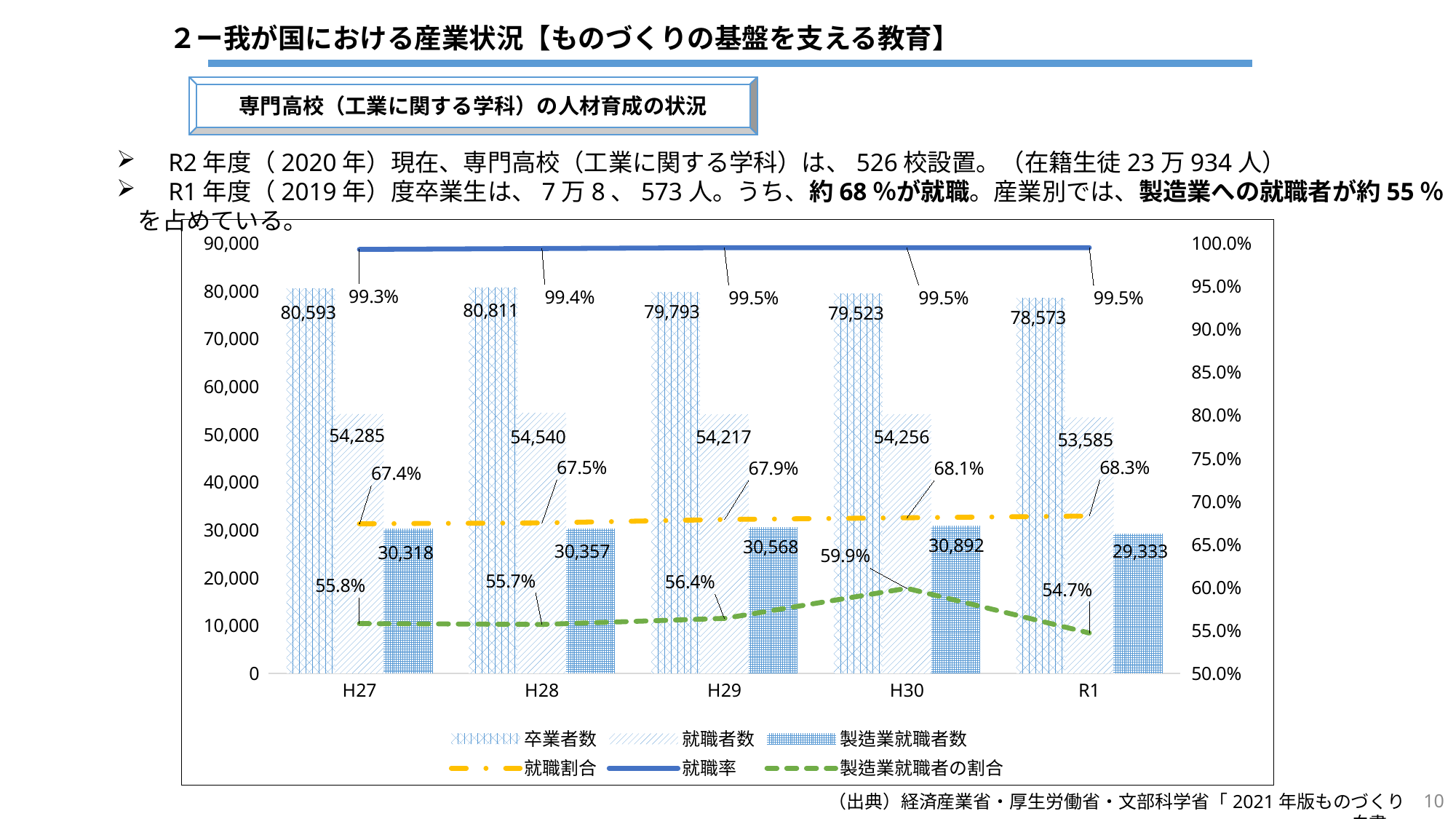
Which year has the highest 製造業就職者の割合? H30 What is the difference between 卒業者数 and 就職者数 for H27? 26,308 Which series is drawn as a solid blue line? 就職率 Does 就職割合 rise or fall from H27 to R1? rise Which year has the lowest 卒業者数? R1 What is the 製造業就職者の割合 for H29? 56.4% What is the 就職割合 for H30? 68.1% How many years are shown on the x axis? 5 What is the value of 製造業就職者数 for R1? 29,333 How many series does the legend list? 6 What is the value of 卒業者数 for H28? 80,811 Is 就職者数 larger for H28 or for R1? H28